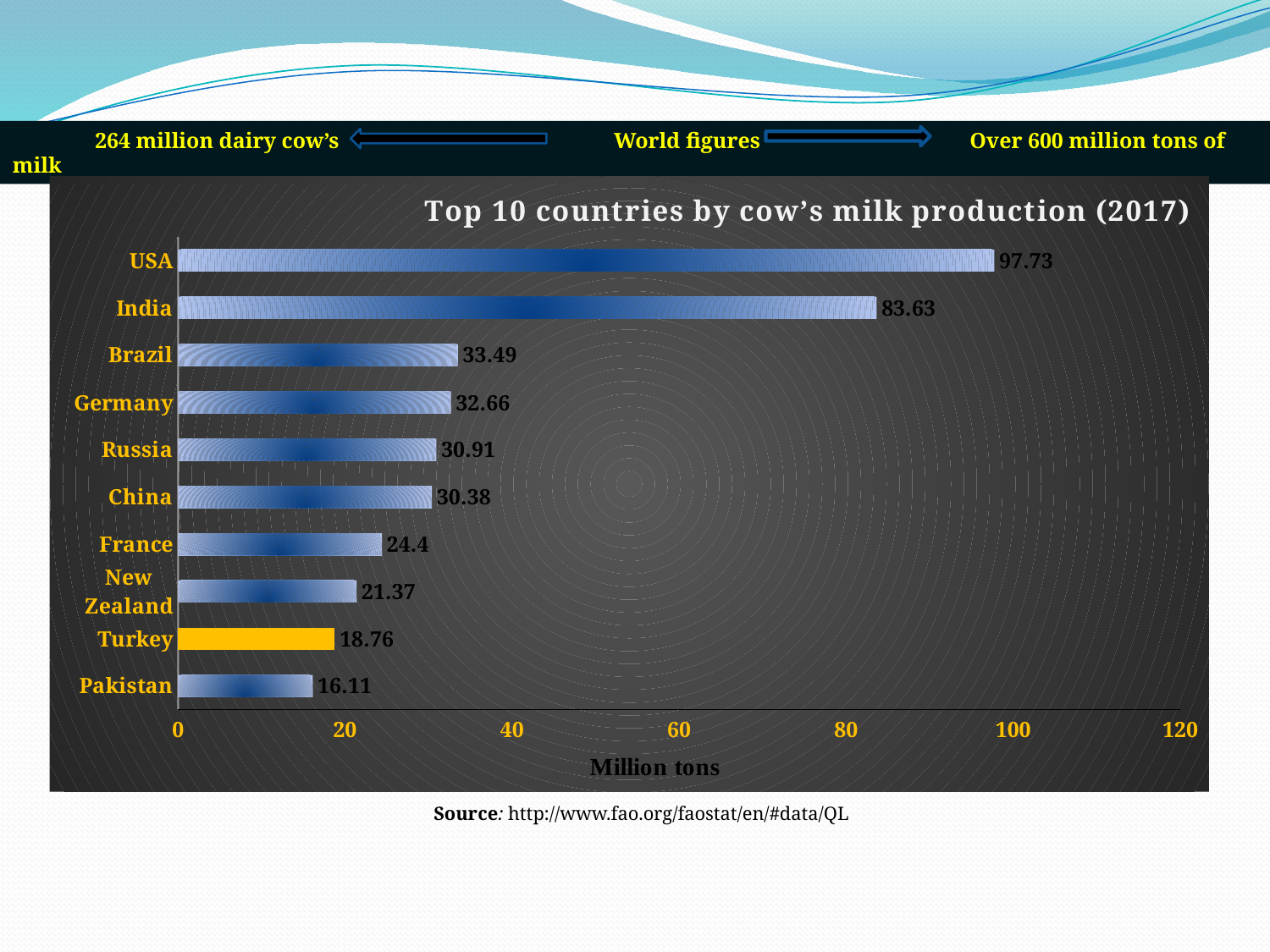
Which country's bar is coloured differently (yellow) from the others? Turkey Which has a larger value, Brazil or Germany? Brazil What kind of chart is shown on the slide? Bar chart Is the value for France greater or less than 20? greater What is the difference between the values for Turkey and Pakistan? 2.65 How many countries are shown in the chart? 10 Which country has the highest cow's milk production in the chart? USA What is the cow's milk production value shown for India? 83.63 What is the title of the chart? Top 10 countries by cow's milk production (2017) Which country has the lowest cow's milk production in the chart? Pakistan What is the difference between the values for USA and India? 14.1 What value is shown for Turkey in the chart? 18.76